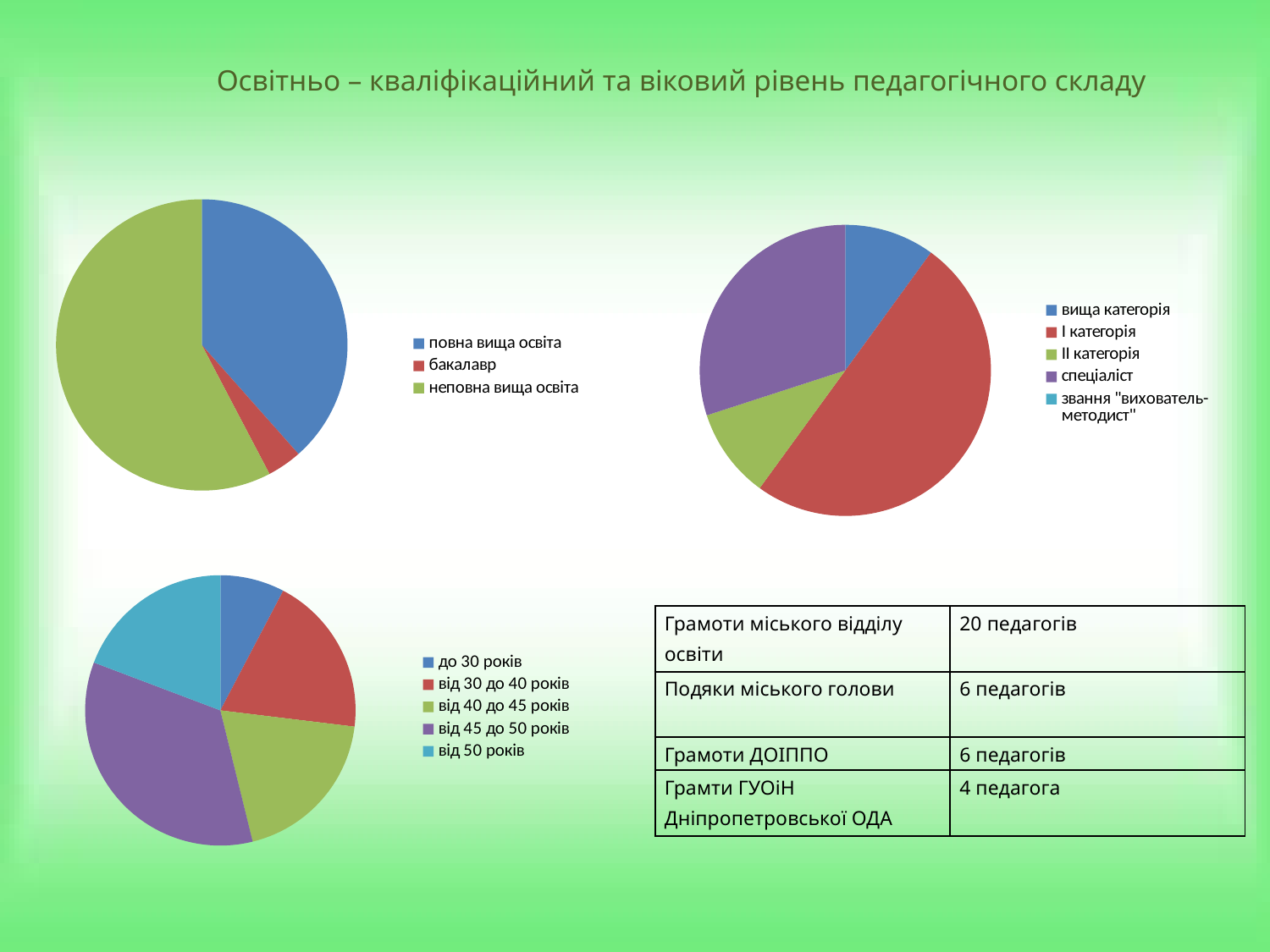
In the top-left pie chart, what colour is the slice for повна вища освіта? blue How many categories does the legend of the top-left pie chart list? 3 In the bottom-left pie chart, which slice is larger: від 45 до 50 років or від 30 до 40 років? від 45 до 50 років In the top-right pie chart, which slice is larger: I категорія or спеціаліст? I категорія In the top-left pie chart, which category has the largest slice? неповна вища освіта In the bottom-left pie chart, which age group has the largest slice? від 45 до 50 років How many entries does the legend of the top-right pie chart list? 5 In the top-left pie chart, which category has the smallest slice? бакалавр What kind of chart is the top-left chart on the slide? pie chart In the top-right pie chart, which slice is larger: спеціаліст or вища категорія? спеціаліст In the top-right pie chart, which category has the largest slice? I категорія In the bottom-left pie chart, which age group has the smallest slice? до 30 років